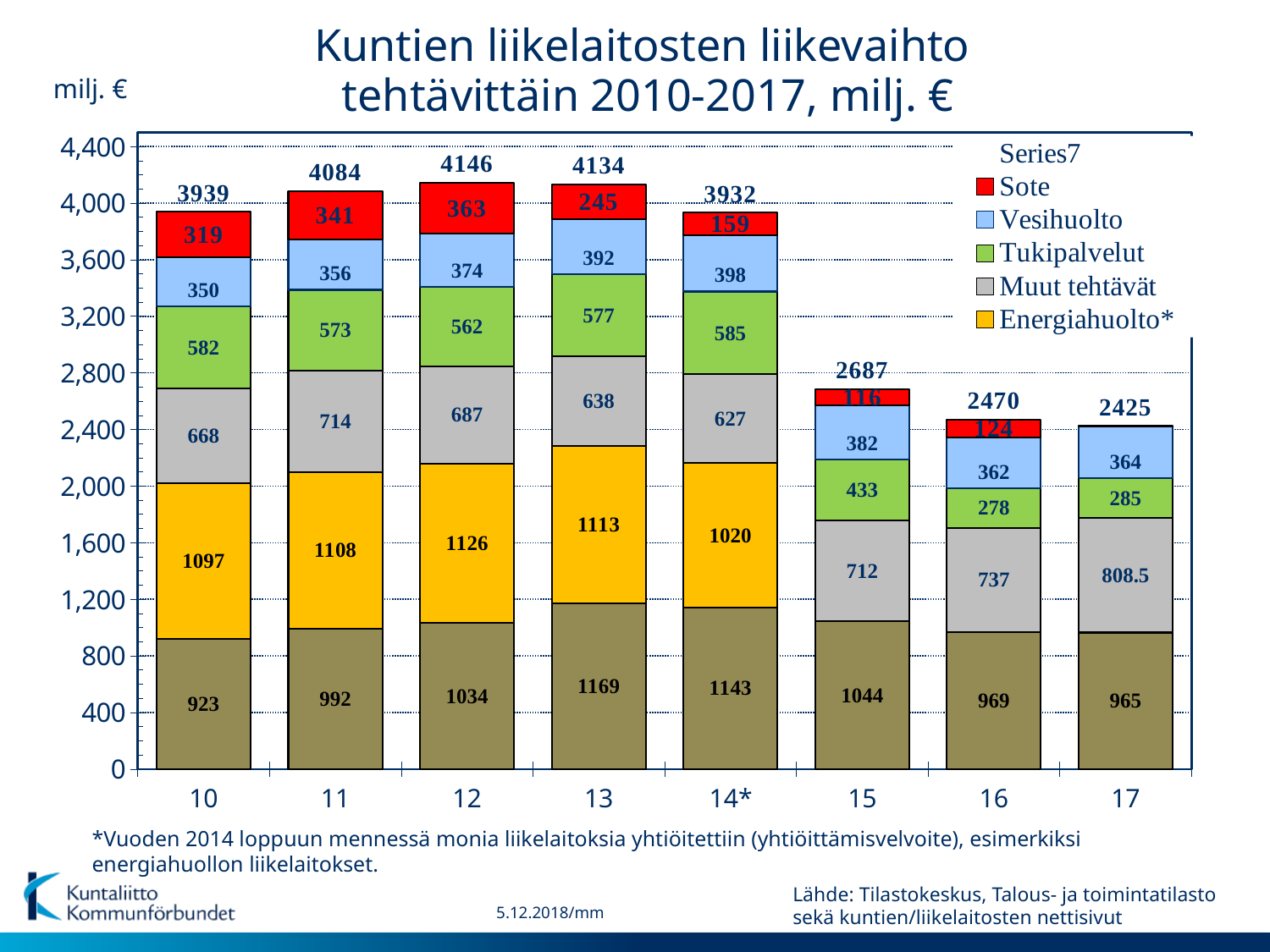
Which year has the larger Tukipalvelut value, 13 or 14*? 14* Which year has the highest total liikevaihto? 12 What colour represents Sote in the chart? red What is the Energiahuolto* value for year 11? 1108 Do the bar totals rise or fall from year 14* to year 17? fall How many years (bars) are shown on the x axis? 8 What kind of chart is shown on the slide? stacked bar chart What is the Vesihuolto value for year 15? 382 Which year has the lowest total liikevaihto? 17 What is the Sote value for year 12? 363 What is the difference between the Muut tehtävät values for year 17 and year 16? 71.5 What is the total value printed above the bar for year 12? 4146